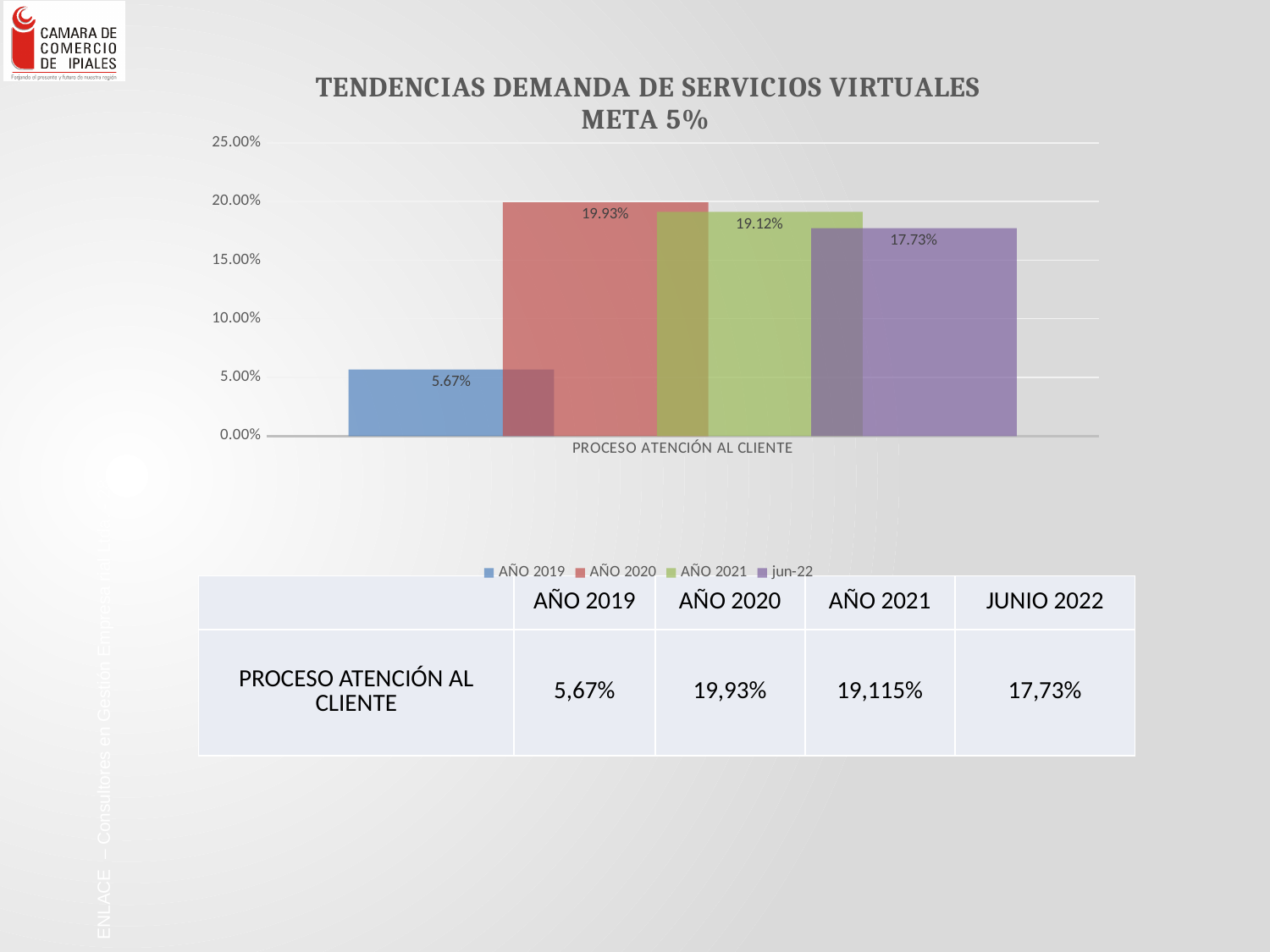
What is the value for AÑO 2019 in the chart? 5.67% How many series does the legend list? 4 Which series has the highest value in the chart? AÑO 2020 What is the value for AÑO 2021 in the chart? 19.12% What is the difference between the AÑO 2020 value and the AÑO 2019 value? 14.26% Which is larger, the value for AÑO 2021 or the value for jun-22? AÑO 2021 Which series has the lowest value in the chart? AÑO 2019 What is the difference between the AÑO 2020 value and the jun-22 value? 2.20% What is the value for AÑO 2020 in the chart? 19.93% Is the value for AÑO 2019 greater or less than 10.00%? less What is the value for jun-22 in the chart? 17.73% What kind of chart is shown on the slide? bar chart